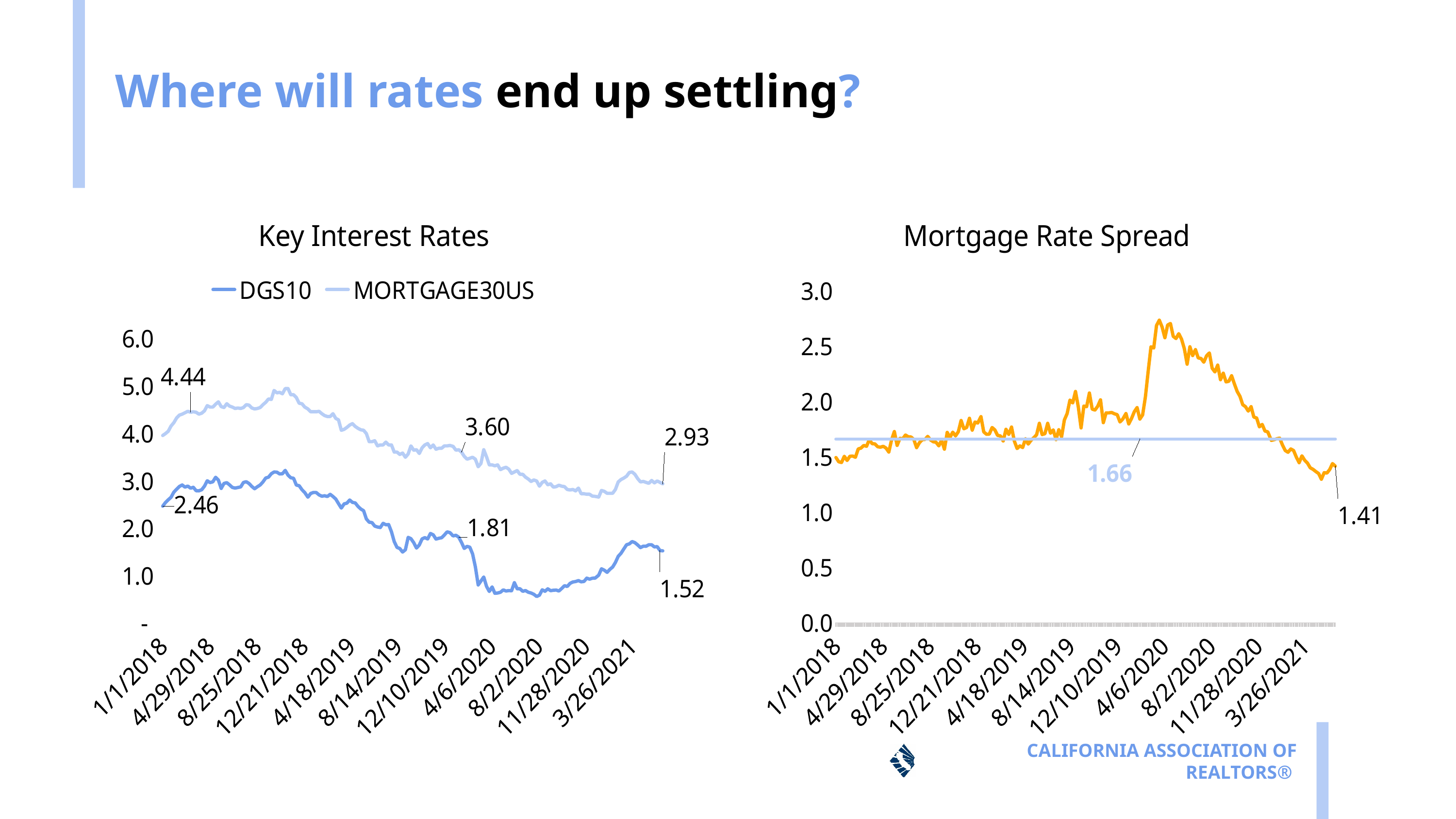
In the Key Interest Rates chart, which series is higher throughout the period, DGS10 or MORTGAGE30US? MORTGAGE30US How many series does the legend of the Key Interest Rates chart list? 2 In the Key Interest Rates chart, what is the last labelled value of the MORTGAGE30US series? 2.93 In the Key Interest Rates chart, does the DGS10 series rise or fall from its first labelled value (2.46) to its last labelled value (1.52)? fall In the Key Interest Rates chart, what is the difference between the first labelled MORTGAGE30US value (4.44) and the first labelled DGS10 value (2.46)? 1.98 In the Mortgage Rate Spread chart, what is the labelled value at the end of the series? 1.41 What kind of chart is the Key Interest Rates chart? line chart In the Key Interest Rates chart, what is the difference between the final labelled MORTGAGE30US value (2.93) and the final labelled DGS10 value (1.52)? 1.41 In the Mortgage Rate Spread chart, is the peak of the spread around 4/6/2020 greater or less than 2.5? greater In the Key Interest Rates chart, is the DGS10 value around 8/2/2020 greater or less than 1.0? less In the Key Interest Rates chart, what is the first labelled value of the MORTGAGE30US series? 4.44 In the Key Interest Rates chart, what is the last labelled value of the DGS10 series? 1.52